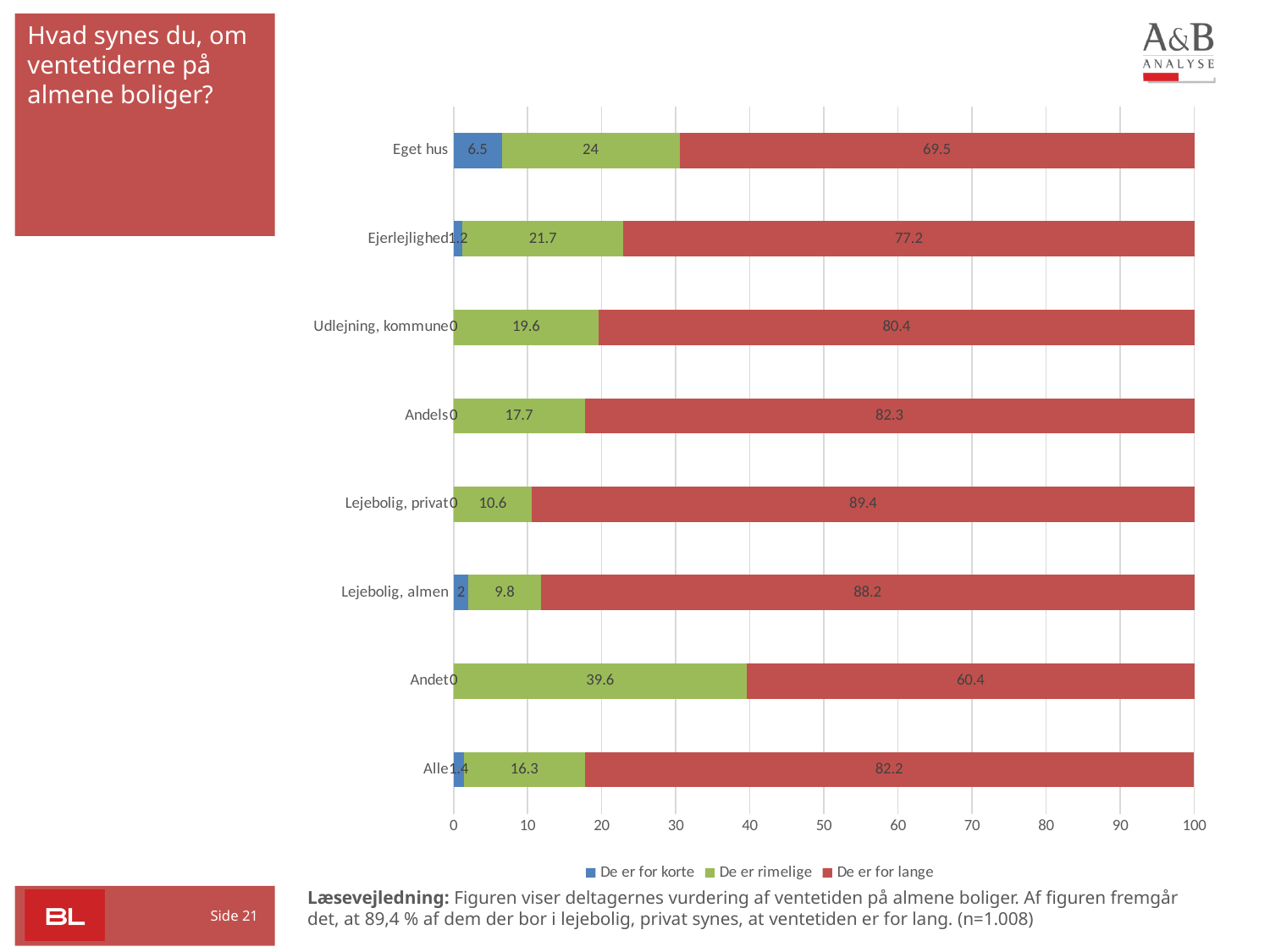
Which category has the lowest value for "De er rimelige"? Lejebolig, almen What kind of chart is shown on the slide? Stacked bar chart Which is larger: the "De er rimelige" value for Eget hus or for Ejerlejlighed? Eget hus How many categories are shown on the y axis? 8 What is the difference between the "De er for lange" values for Lejebolig, privat and Andet? 29 Which category has the highest value for "De er for lange"? Lejebolig, privat Which colour represents "De er for lange" in the chart? Red What is the value of "De er for lange" for Eget hus? 69.5 What is the value of "De er for korte" for Eget hus? 6.5 How many series does the legend list? 3 What is the value of "De er for lange" for Alle? 82.2 What is the value of "De er rimelige" for Andet? 39.6